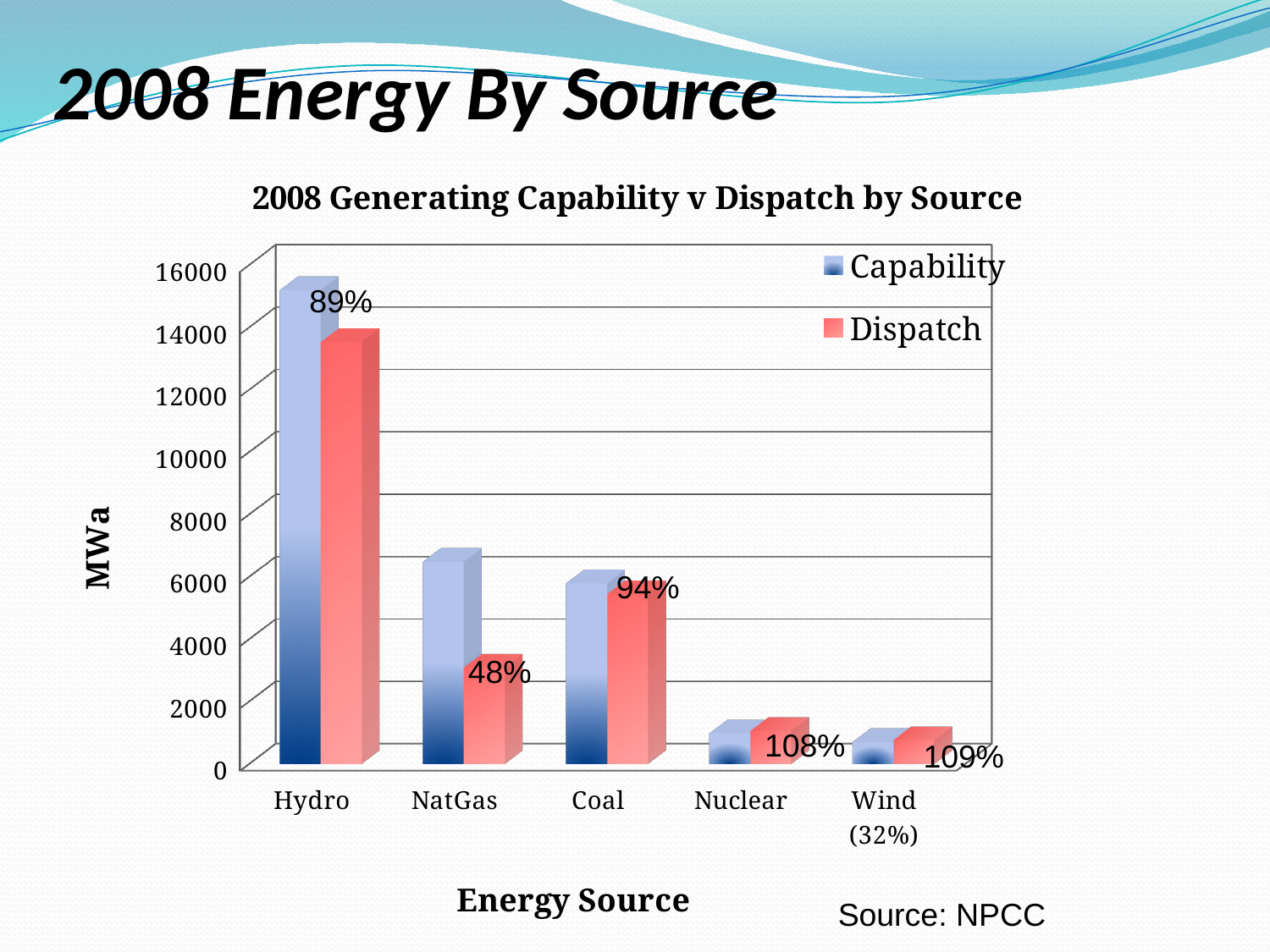
How many energy source categories are shown on the x axis? 5 Is the Dispatch value for NatGas greater or less than 4000? less Is the Capability value for Hydro greater or less than 14000? greater How many series does the legend list? 2 Do the Capability values rise or fall moving from Hydro to Wind along the x axis? Fall What percentage label is printed next to the NatGas bars? 48% Which energy source has the highest Capability? Hydro Which energy source has the lowest Capability? Wind For NatGas, which is larger, Capability or Dispatch? Capability Which has the larger Capability, Hydro or Coal? Hydro What kind of chart is shown on the slide? Bar chart Is the Capability value for Nuclear greater or less than 2000? less